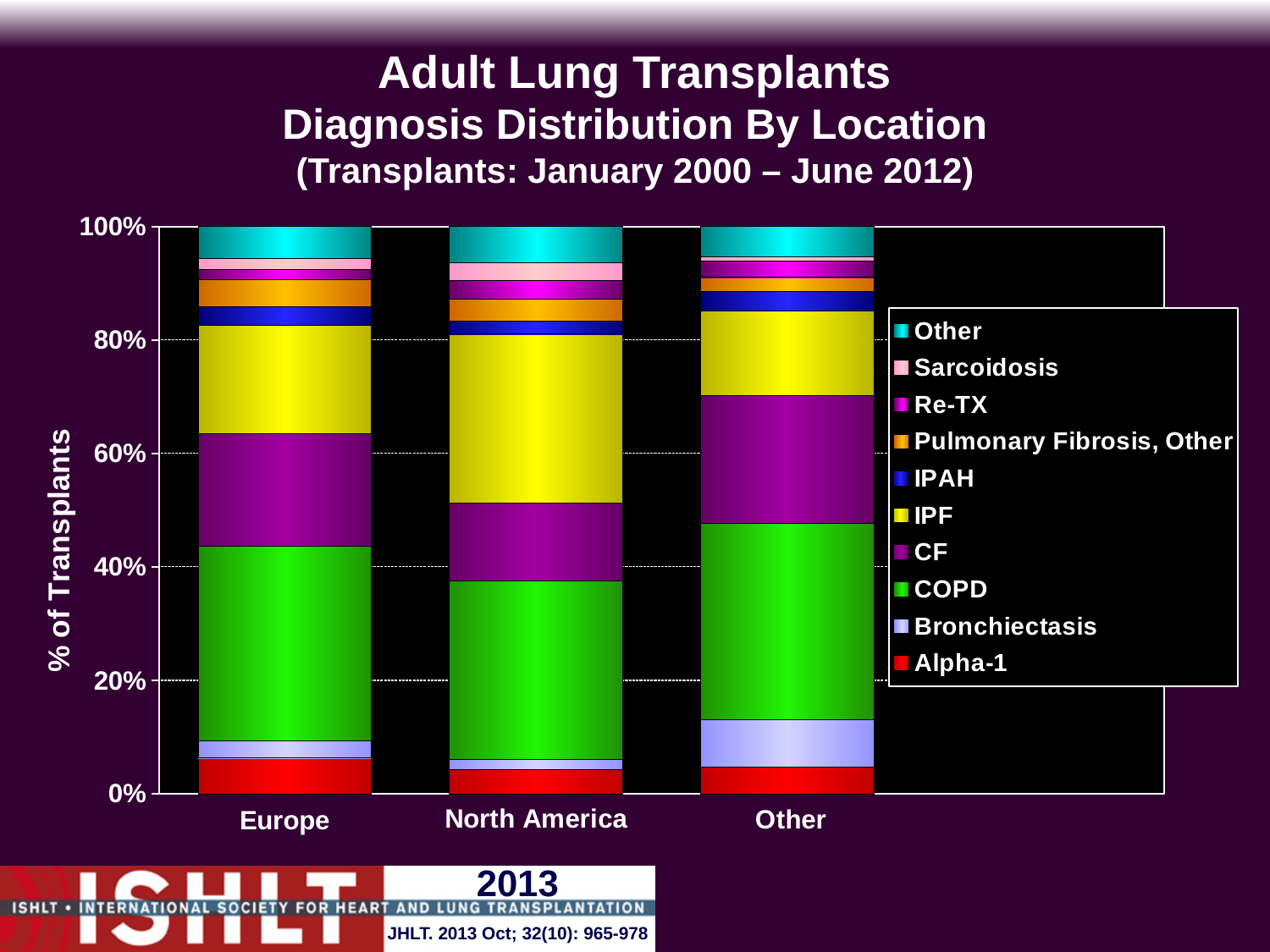
What is the total height of the Europe stacked bar? 100% How many diagnosis series does the legend list? 10 What is the label on the y axis? % of Transplants In the Europe bar, does the top of the COPD segment sit above or below the 40% gridline? above What kind of chart is shown on the slide? Stacked bar chart Is the IPF segment larger for North America or for Other? North America Which location has the largest Bronchiectasis segment? Other What is the title of the chart? Adult Lung Transplants Diagnosis Distribution By Location Which location has the smallest CF segment? North America Which location has the largest IPF segment? North America How many locations (categories) are shown on the x axis? 3 In the North America bar, does the top of the CF segment sit above or below the 60% gridline? below